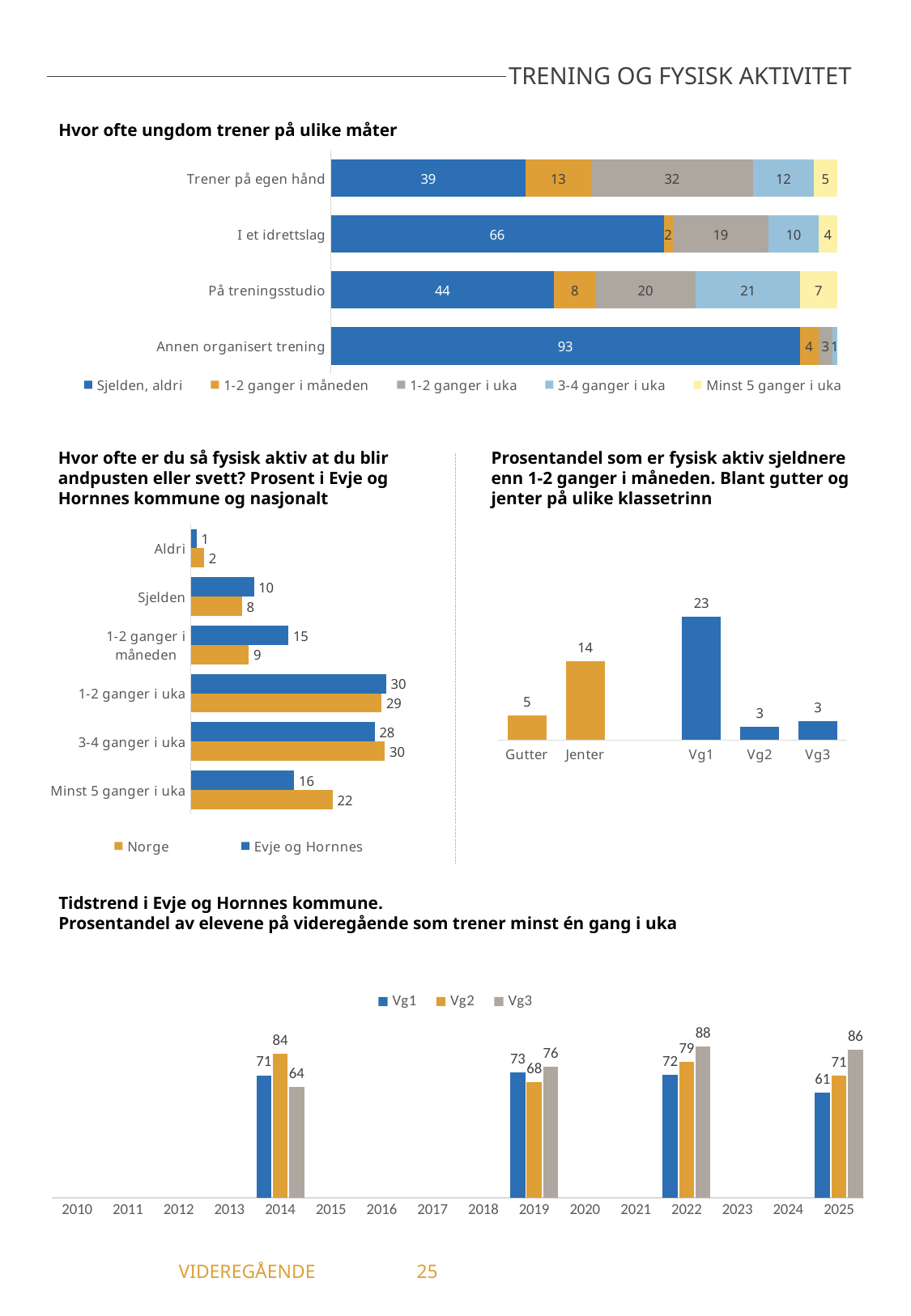
In the chart 'Hvor ofte ungdom trener på ulike måter', what is the total of the 'På treningsstudio' bar? 100 In the chart 'Prosentandel som er fysisk aktiv sjeldnere enn 1-2 ganger i måneden', which category has the highest value? Vg1 In the chart 'Hvor ofte ungdom trener på ulike måter', how many series does the legend list? 5 In the chart 'Prosentandel som er fysisk aktiv sjeldnere enn 1-2 ganger i måneden', which is larger, Gutter or Jenter? Jenter In the chart 'Hvor ofte er du så fysisk aktiv at du blir andpusten eller svett?', what is the value for Norge in the 'Minst 5 ganger i uka' category? 22 In the chart 'Tidstrend i Evje og Hornnes kommune', what is the value for Vg3 in 2025? 86 In the chart 'Hvor ofte ungdom trener på ulike måter', which category has the highest 'Sjelden, aldri' value? Annen organisert trening In the chart 'Hvor ofte er du så fysisk aktiv at du blir andpusten eller svett?', what is the difference between Evje og Hornnes and Norge for '1-2 ganger i måneden'? 6 In the chart 'Prosentandel som er fysisk aktiv sjeldnere enn 1-2 ganger i måneden', what is the value for Jenter? 14 In the chart 'Hvor ofte ungdom trener på ulike måter', what is the value for 'Sjelden, aldri' in the 'I et idrettslag' bar? 66 In the chart 'Hvor ofte er du så fysisk aktiv at du blir andpusten eller svett?', how many categories are shown? 6 In the chart 'Tidstrend i Evje og Hornnes kommune', what kind of chart is it? Bar chart